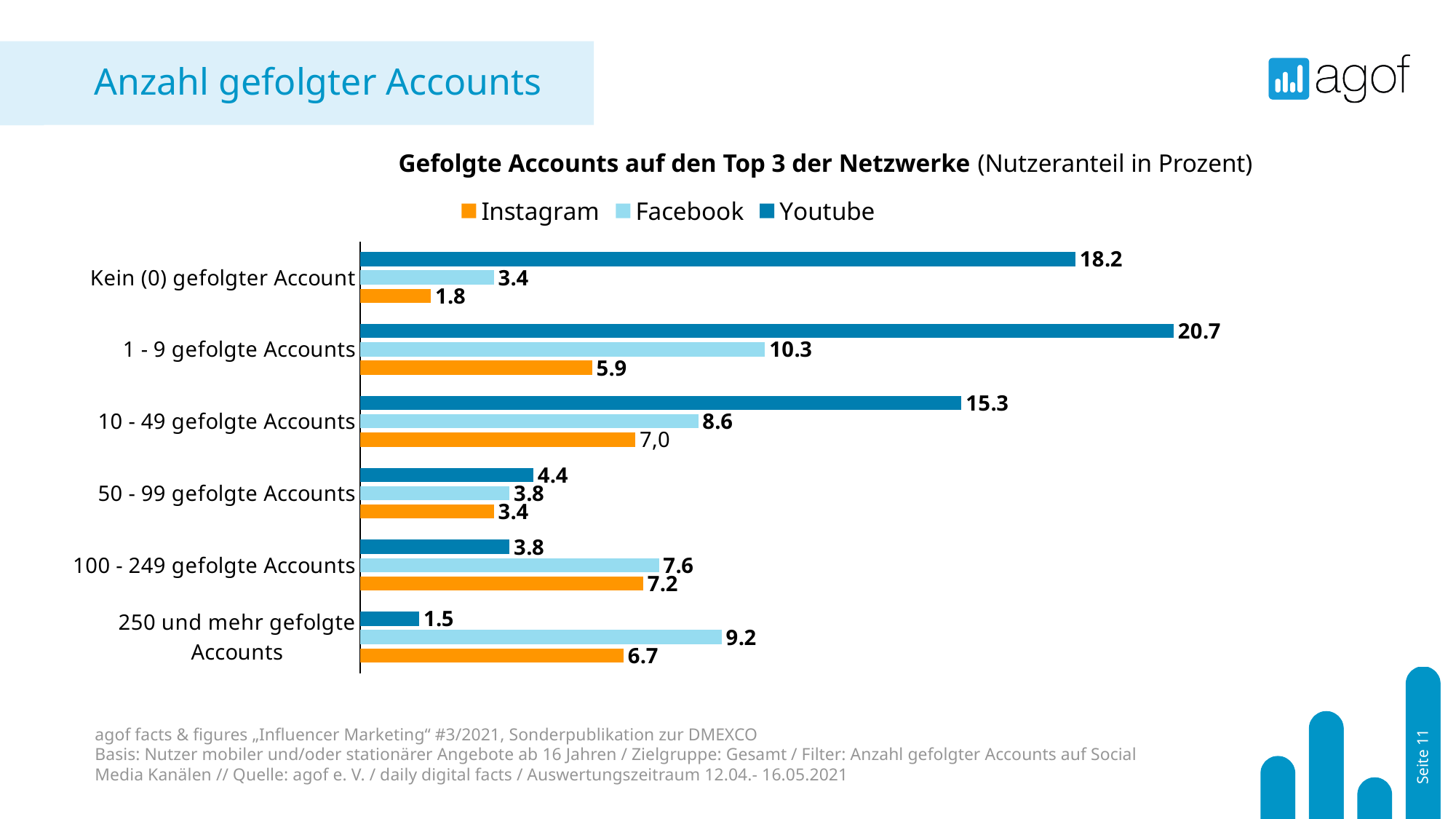
What is the difference between the Facebook and Instagram values for "1 - 9 gefolgte Accounts"? 4.4 Which is larger for "100 - 249 gefolgte Accounts": the Facebook value or the Youtube value? Facebook How many series does the legend list? 3 What is the Facebook value for "250 und mehr gefolgte Accounts"? 9.2 How many categories are shown on the y axis? 6 What is the Youtube value for "1 - 9 gefolgte Accounts"? 20.7 What kind of chart is shown on the slide? Bar chart What is the difference between the Youtube and Instagram values for "Kein (0) gefolgter Account"? 16.4 What is the Instagram value for "Kein (0) gefolgter Account"? 1.8 Which category has the lowest Instagram value? Kein (0) gefolgter Account Which series is shown in orange? Instagram Which category has the highest Youtube value? 1 - 9 gefolgte Accounts